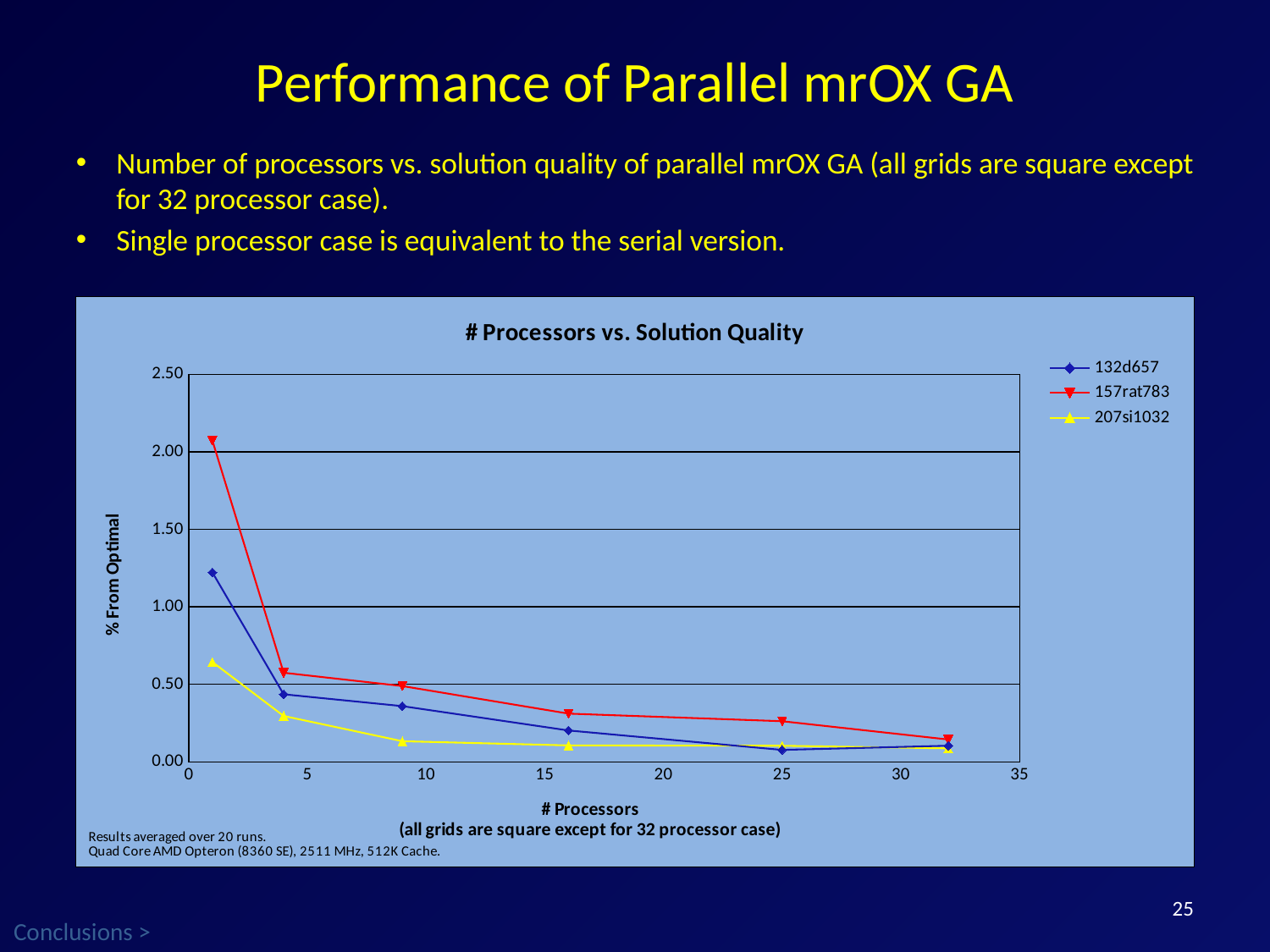
Which series has the lowest value at 1 processor? 207si1032 Is the value for 207si1032 at 1 processor greater or less than 0.50? greater How many series does the legend list? 3 What is the label on the vertical axis of the chart? % From Optimal At 16 processors, which is larger: the value for 157rat783 or the value for 207si1032? 157rat783 How many data points are plotted for the 157rat783 series? 6 Is the value for 132d657 at 1 processor greater or less than 1.00? greater Do the values for 132d657 rise or fall as the number of processors increases? fall Is the value for 157rat783 at 16 processors greater or less than 0.50? less What kind of chart is shown on the slide? line chart Which series has the highest value at 1 processor? 157rat783